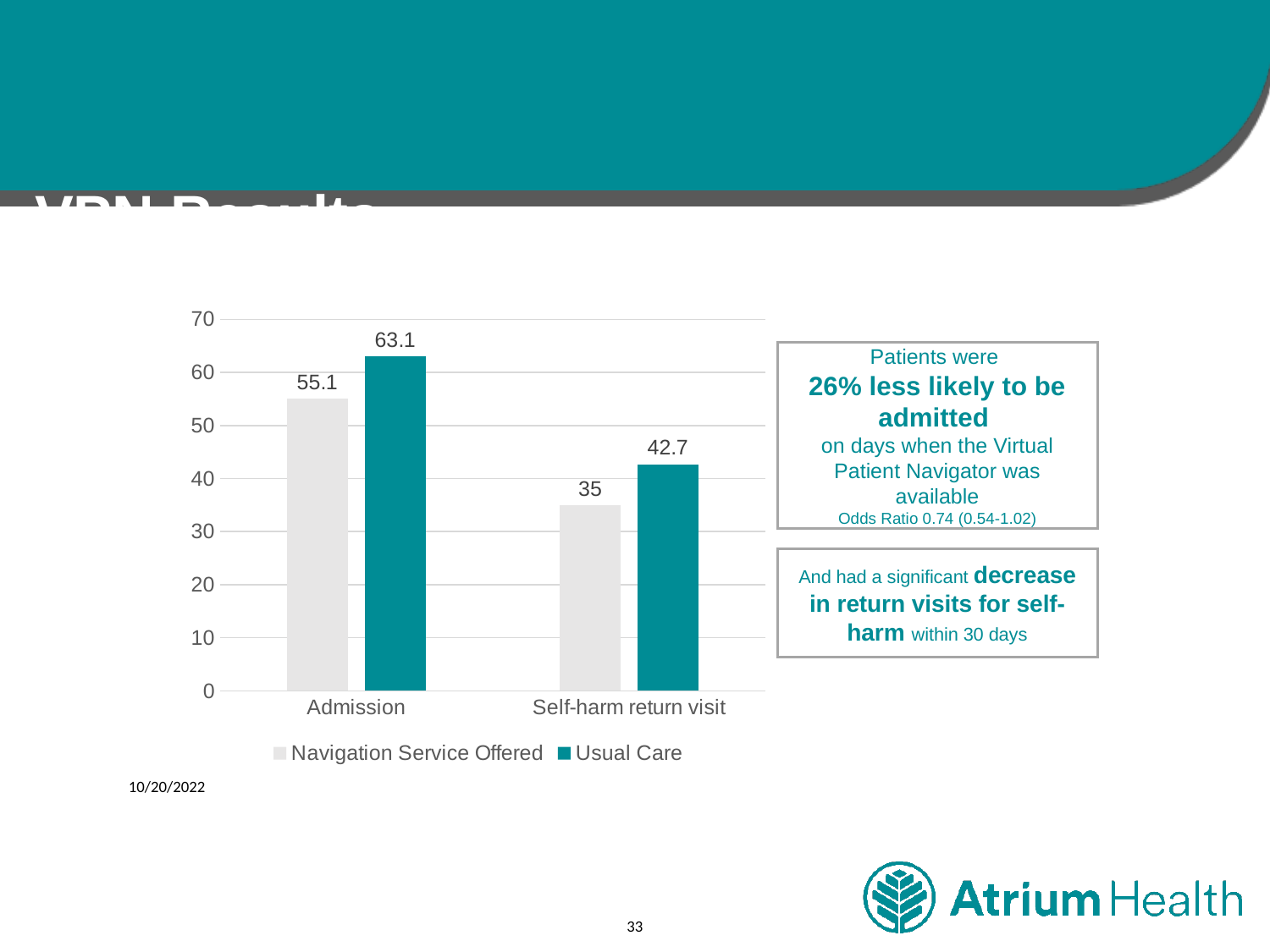
What is the value for Navigation Service Offered in the Self-harm return visit category? 35 What is the difference between Usual Care and Navigation Service Offered in the Self-harm return visit category? 7.7 Which bar has the lowest value on the chart? Navigation Service Offered, Self-harm return visit In the Self-harm return visit category, which series has the larger value, Navigation Service Offered or Usual Care? Usual Care What kind of chart is shown on the slide? Bar chart What is the value for Navigation Service Offered in the Admission category? 55.1 What is the value for Usual Care in the Admission category? 63.1 How many series does the legend list? 2 How many categories are shown on the x axis? 2 Which bar has the highest value on the chart? Usual Care, Admission What is the difference between Usual Care and Navigation Service Offered in the Admission category? 8 What is the value for Usual Care in the Self-harm return visit category? 42.7